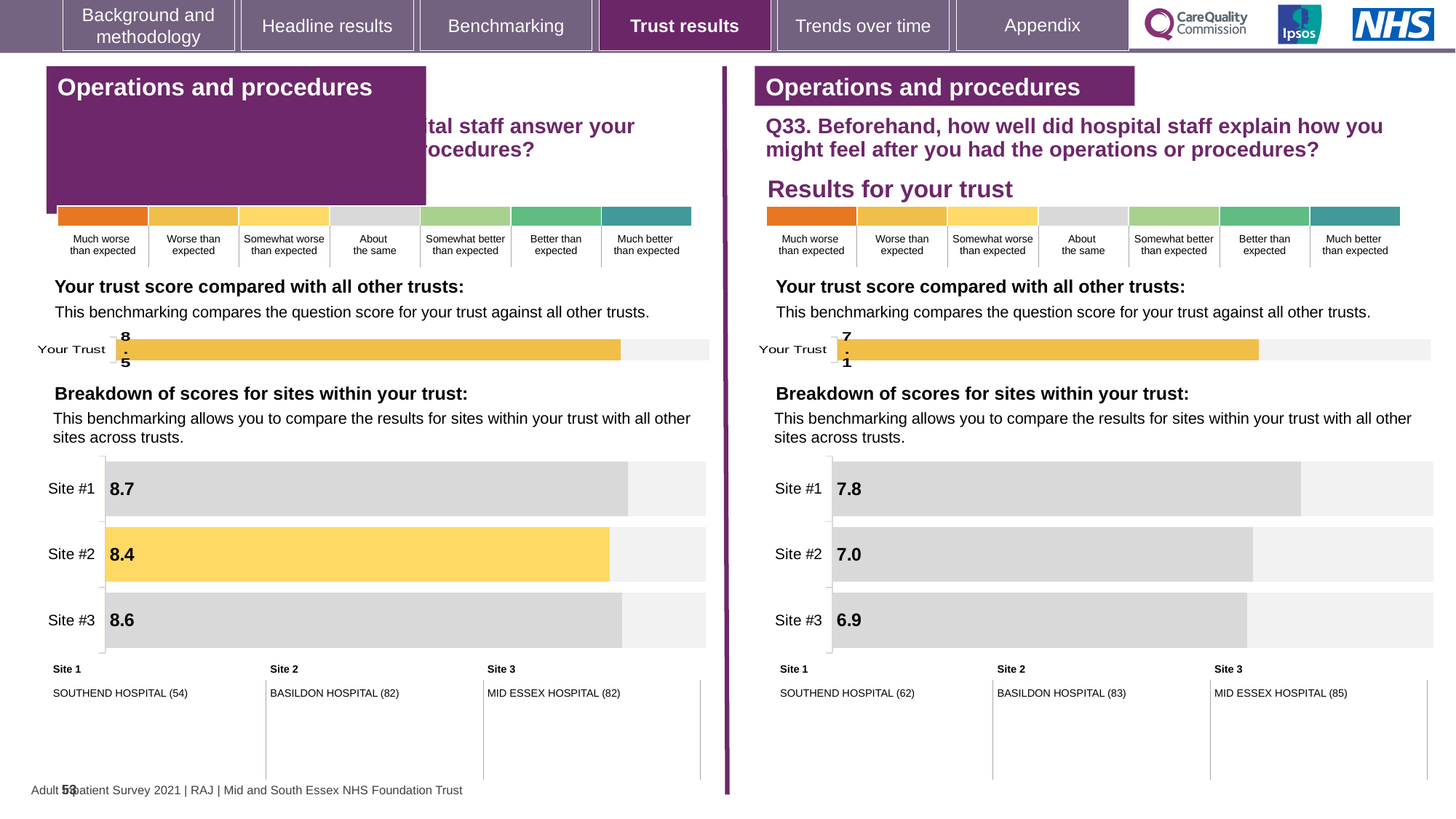
In the right-hand (Q33) 'Breakdown of scores for sites within your trust' chart, what is the difference between the scores for Site #1 and Site #2? 0.8 How many sites are shown in the left-hand 'Breakdown of scores for sites within your trust' chart? 3 In the left-hand 'Breakdown of scores for sites within your trust' chart, what is the difference between the scores for Site #1 and Site #3? 0.1 In the left-hand 'Breakdown of scores for sites within your trust' chart, what is the score for Site #2? 8.4 In the left-hand 'Breakdown of scores for sites within your trust' chart, which site has the lowest score? Site #2 In the left-hand 'Your trust score compared with all other trusts' chart, what is the score for Your Trust? 8.5 What kind of chart is the right-hand (Q33) 'Breakdown of scores for sites within your trust' chart? Bar chart In the left-hand 'Breakdown of scores for sites within your trust' chart, what is the score for Site #1? 8.7 In the right-hand (Q33) 'Breakdown of scores for sites within your trust' chart, which is larger, the score for Site #2 or Site #3? Site #2 In the right-hand (Q33) 'Breakdown of scores for sites within your trust' chart, what is the score for Site #3? 6.9 In the right-hand (Q33) 'Your trust score compared with all other trusts' chart, what is the score for Your Trust? 7.1 In the right-hand (Q33) 'Breakdown of scores for sites within your trust' chart, which site has the highest score? Site #1